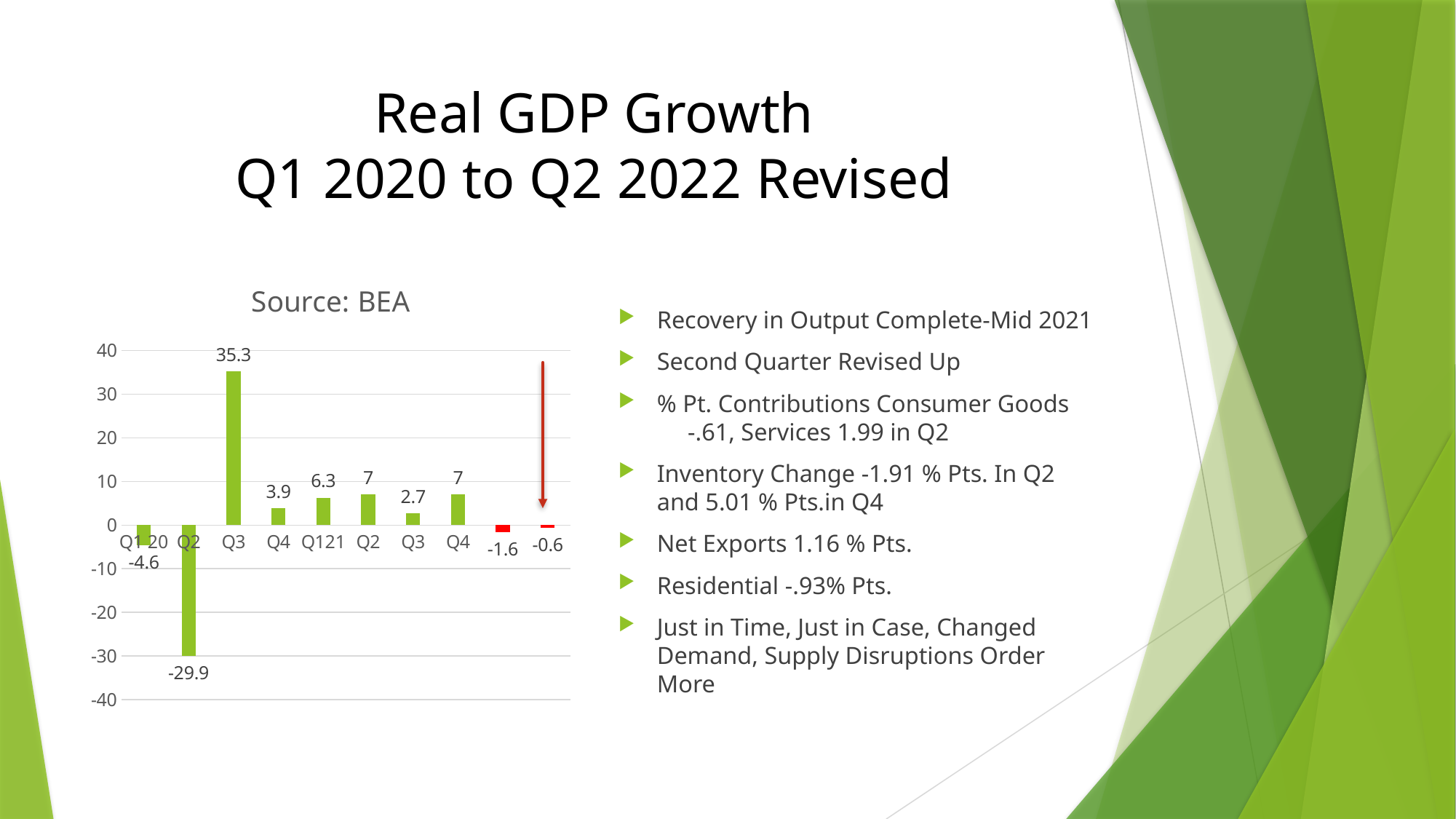
What is the value for Q2 2020 in the chart? -29.9 How many bars are plotted in the chart? 10 Which is larger, the value for Q1 2021 or the value for Q4 2020? Q1 2021 Which quarter has the highest value in the chart? Q3 2020 What is the difference between the values for Q3 2020 and Q4 2020? 31.4 Which quarter has the lowest value in the chart? Q2 2020 What is the value for Q3 2020 in the chart? 35.3 What kind of chart is shown on the slide? Bar chart What is the title shown above the chart? Source: BEA What is the difference between the values for Q1 2021 and Q3 2021? 3.6 What is the value for Q1 2021 in the chart? 6.3 What is the value for Q3 2021 in the chart? 2.7